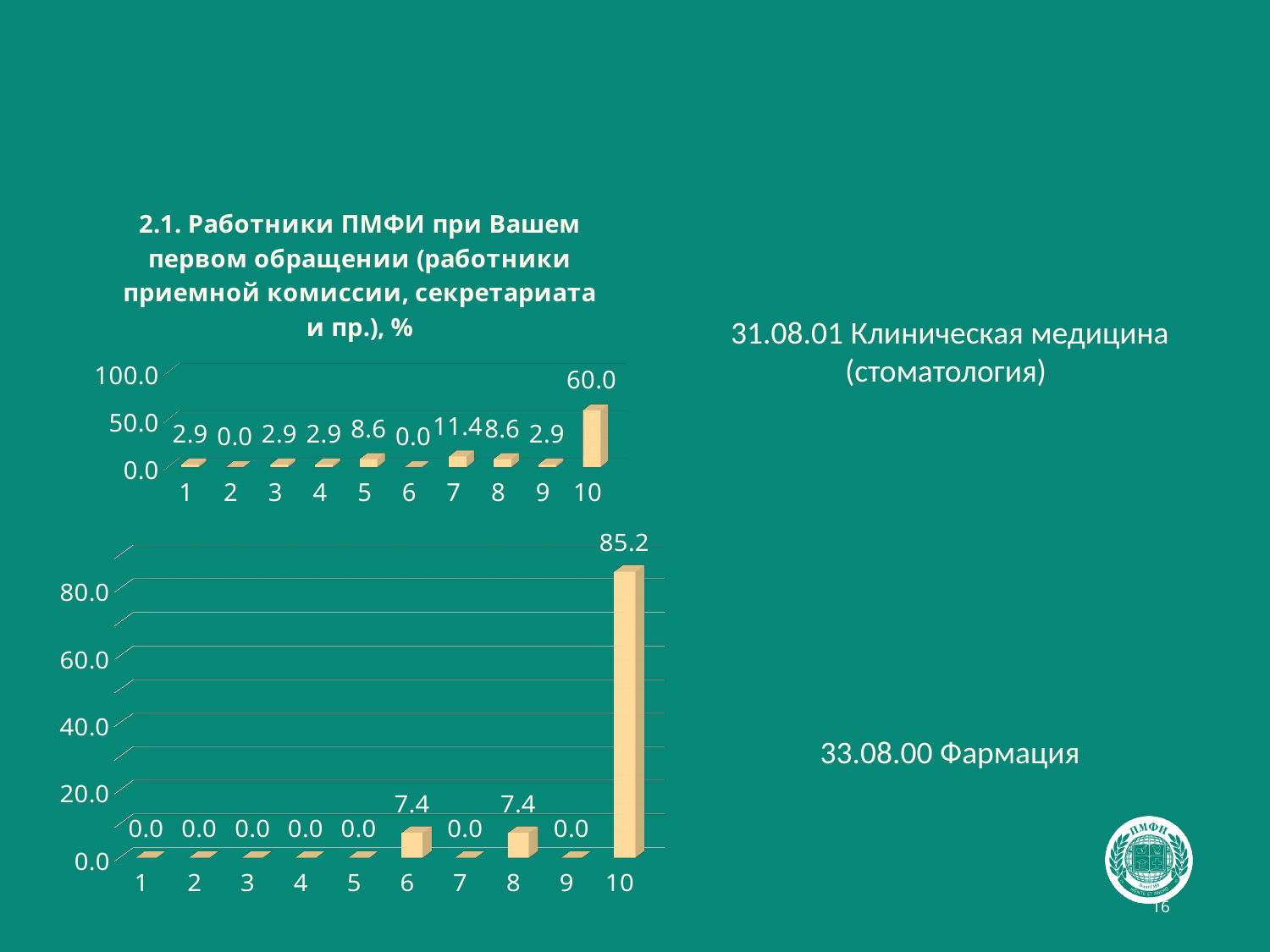
In the top chart, what is the value for category 10? 60.0 In the top chart, which is larger, the value for category 5 or the value for category 7? category 7 What kind of chart is the bottom chart? bar chart What is the title of the top chart? 2.1. Работники ПМФИ при Вашем первом обращении (работники приемной комиссии, секретариата и пр.), % In the bottom chart, which category has the highest value? 10 In the bottom chart, what is the value for category 10? 85.2 How many categories are shown on the x axis of the top chart? 10 In the top chart, what is the difference between the values for category 10 and category 7? 48.6 In the bottom chart, what is the value for category 6? 7.4 In the top chart, which category has the highest value? 10 In the bottom chart, what is the difference between the values for category 10 and category 8? 77.8 In the top chart, what is the value for category 7? 11.4